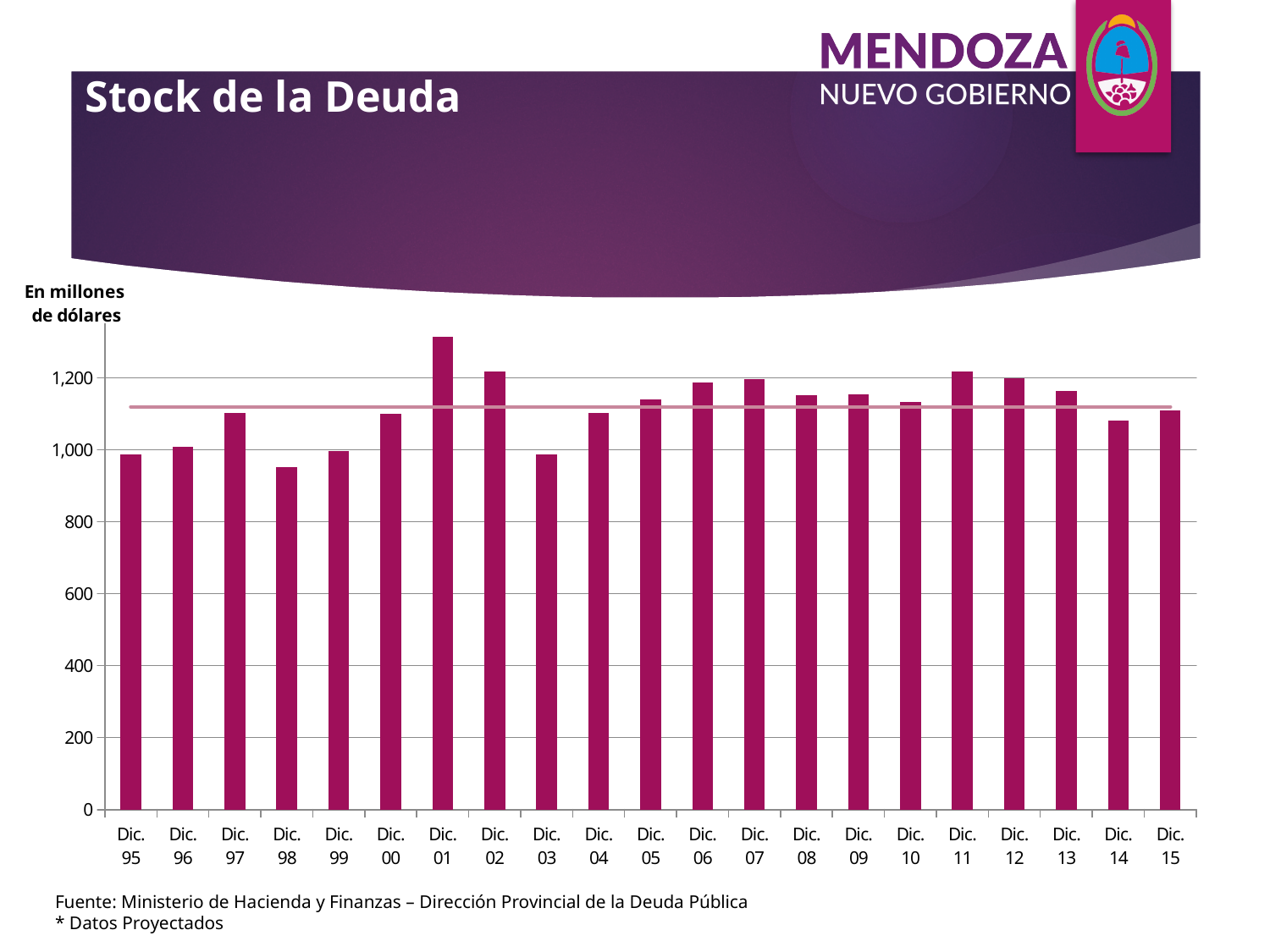
Which is larger, the value for Dic. 02 or the value for Dic. 03? Dic. 02 Do the values rise or fall from Dic. 11 to Dic. 14? fall What unit is indicated for the values on the chart? En millones de dólares Which period has the lowest debt stock? Dic. 98 How many bars (periods) are plotted in the chart? 21 Is the value for Dic. 14 greater or less than 1,000? greater Is the value for Dic. 01 greater or less than 1,200? greater Which period has the highest debt stock? Dic. 01 Which is larger, the value for Dic. 97 or the value for Dic. 98? Dic. 97 Is the value for Dic. 98 greater or less than 1,000? less What kind of chart is shown on the slide? bar chart